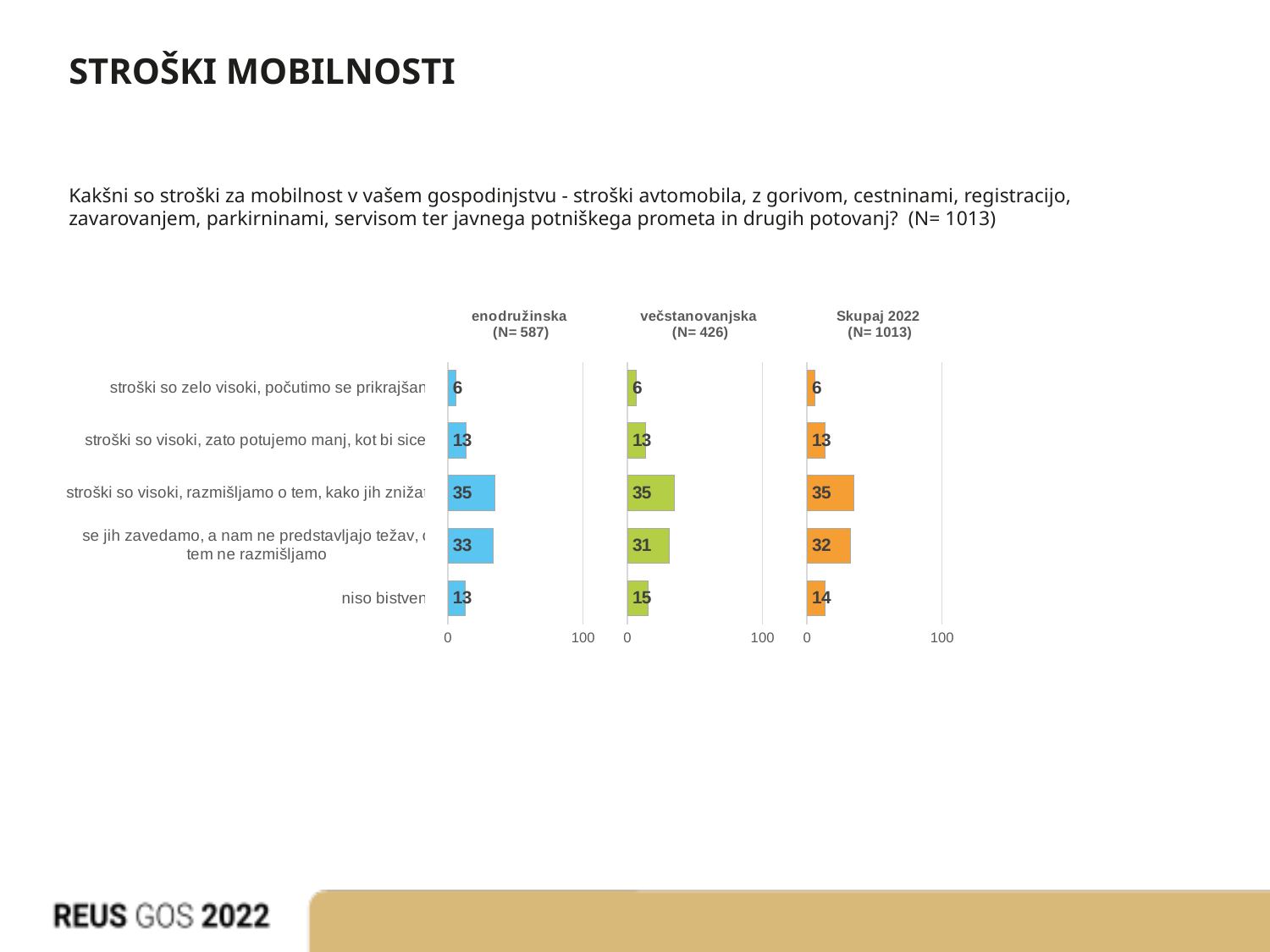
In the 'Skupaj 2022 (N= 1013)' chart, which category has the highest value? stroški so visoki, razmišljamo o tem, kako jih zniža... How many categories are shown in the 'enodružinska (N= 587)' chart? 5 In the 'Skupaj 2022 (N= 1013)' chart, what is the value for 'se jih zavedamo, a nam ne predstavljajo težav, o tem ne razmišljamo'? 32 In the 'večstanovanjska (N= 426)' chart, what is the value for the last category, 'niso bistven...'? 15 How many separate charts are shown on the slide? 3 For the last category 'niso bistven...', which chart shows the larger value: 'enodružinska (N= 587)' or 'večstanovanjska (N= 426)'? večstanovanjska (N= 426) In the 'večstanovanjska (N= 426)' chart, what is the difference between the value for 'stroški so visoki, razmišljamo o tem, kako jih zniža...' and the value for 'se jih zavedamo, a nam ne predstavljajo težav, o tem ne razmišljamo'? 4 In the 'enodružinska (N= 587)' chart, what is the value for 'se jih zavedamo, a nam ne predstavljajo težav, o tem ne razmišljamo'? 33 What kind of chart is the 'Skupaj 2022 (N= 1013)' chart? Bar chart In the 'enodružinska (N= 587)' chart, which category has the lowest value? stroški so zelo visoki, počutimo se prikrajšan... What colour are the bars in the 'večstanovanjska (N= 426)' chart? Green In the 'Skupaj 2022 (N= 1013)' chart, what is the difference between the value for 'se jih zavedamo, a nam ne predstavljajo težav, o tem ne razmišljamo' and the value for 'niso bistven...'? 18